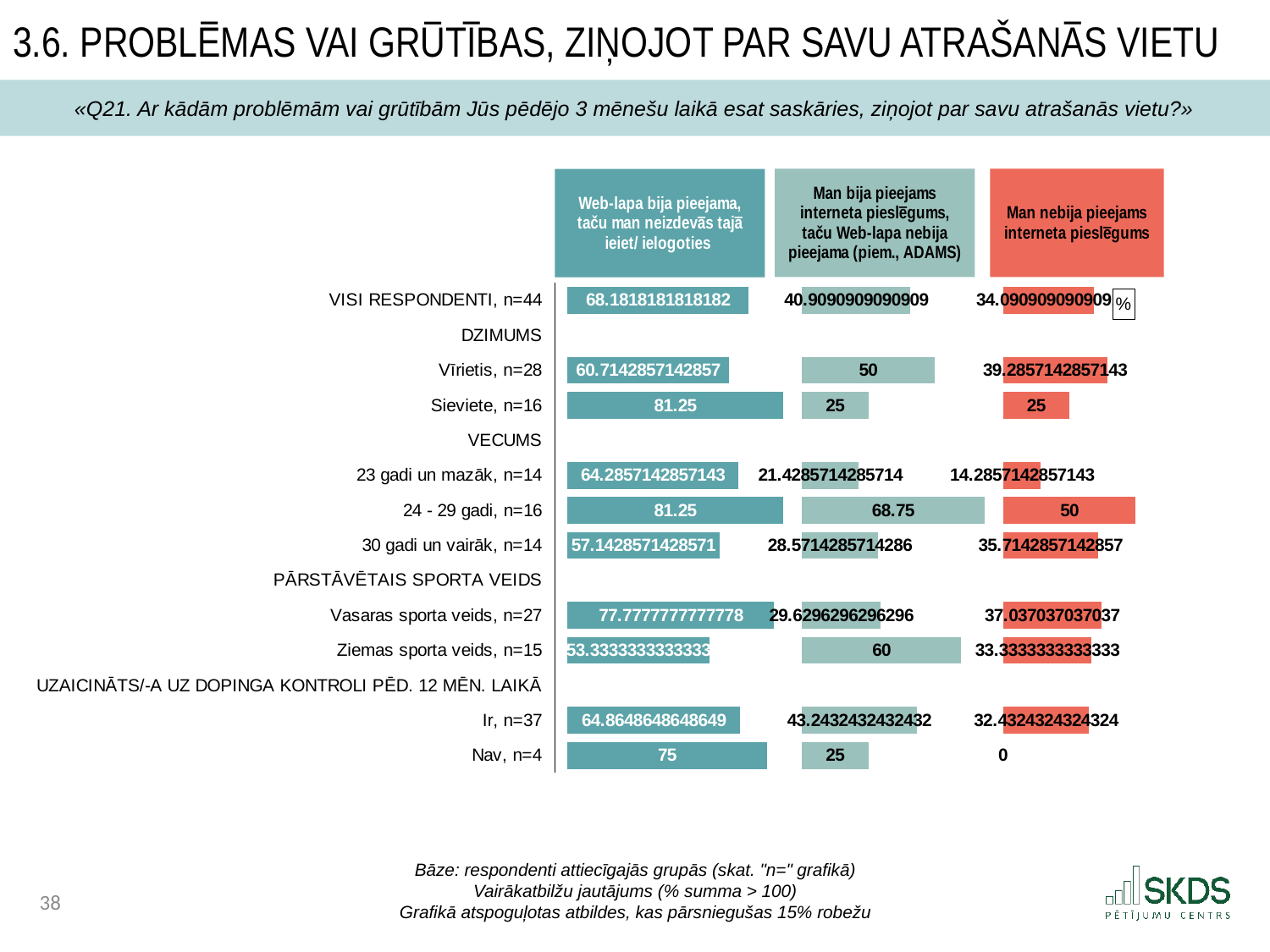
What is the difference between "Sieviete, n=16" and "Nav, n=4" in the "Web-lapa bija pieejama, taču man neizdevās tajā ieiet/ ielogoties" series? 6.25 What is the value for "Sieviete, n=16" in the "Web-lapa bija pieejama, taču man neizdevās tajā ieiet/ ielogoties" series? 81.25 What kind of chart is shown on the slide? Bar chart In the "Man bija pieejams interneta pieslēgums, taču Web-lapa nebija pieejama (piem., ADAMS)" series, which is larger: "Vīrietis, n=28" or "Sieviete, n=16"? Vīrietis, n=28 Which group has the highest value in the "Man bija pieejams interneta pieslēgums, taču Web-lapa nebija pieejama (piem., ADAMS)" series? 24 - 29 gadi, n=16 How many series does the chart show? 3 What is the value for "Nav, n=4" in the "Man nebija pieejams interneta pieslēgums" series? 0 What is the value for "Vīrietis, n=28" in the "Man bija pieejams interneta pieslēgums, taču Web-lapa nebija pieejama (piem., ADAMS)" series? 50 What colour are the bars of the "Man nebija pieejams interneta pieslēgums" series? Red Which group has the lowest value in the "Man nebija pieejams interneta pieslēgums" series? Nav, n=4 What is the value for "24 - 29 gadi, n=16" in the "Man nebija pieejams interneta pieslēgums" series? 50 What is the value for "Ziemas sporta veids, n=15" in the "Man bija pieejams interneta pieslēgums, taču Web-lapa nebija pieejama (piem., ADAMS)" series? 60